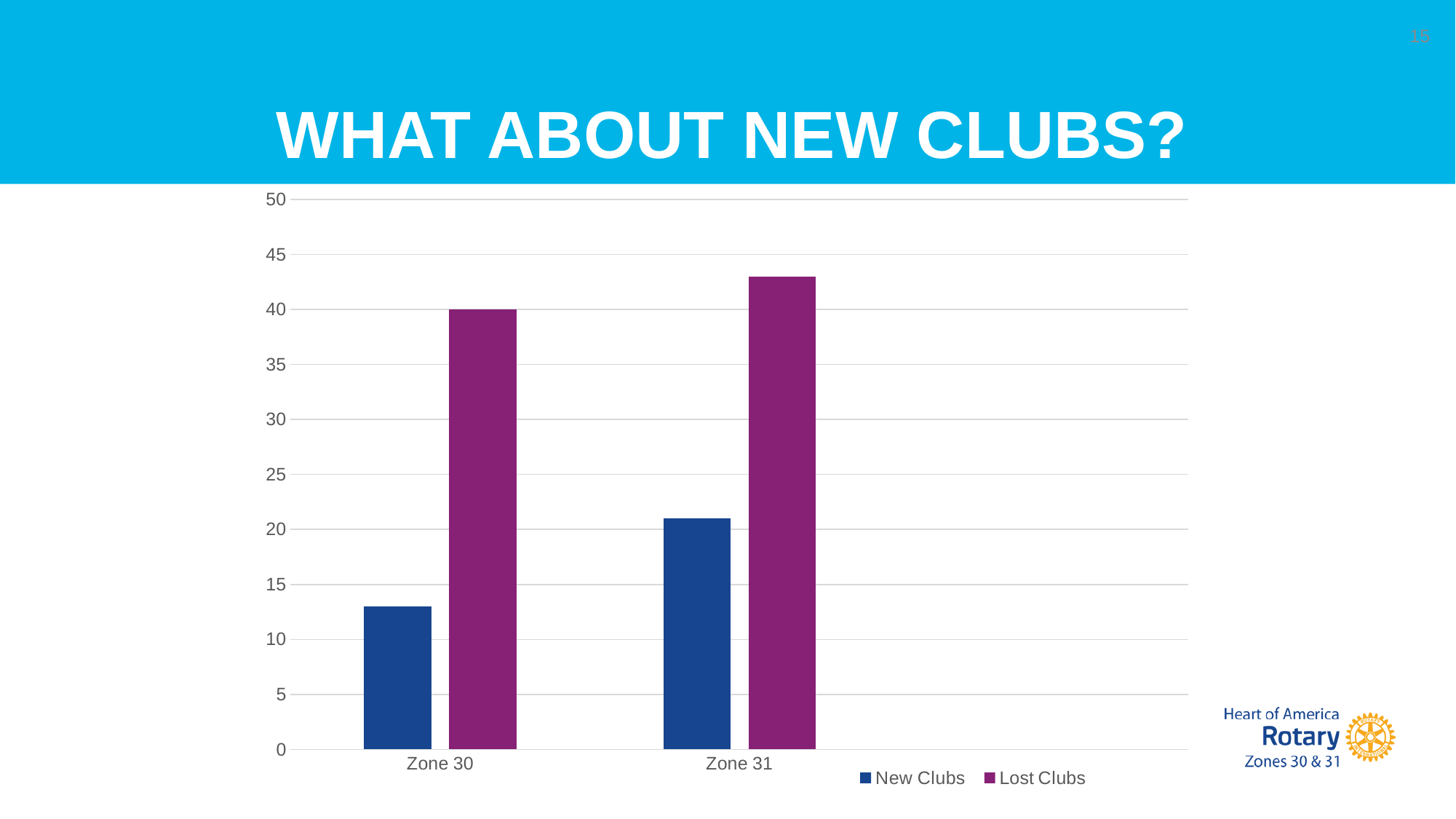
Which zone has the higher value for Lost Clubs? Zone 31 What is the value for Lost Clubs in Zone 30? 40 How many series does the legend list? 2 What kind of chart is shown on the slide? bar chart Is the value for New Clubs in Zone 31 greater or less than 20? greater In Zone 30, which is larger: New Clubs or Lost Clubs? Lost Clubs What is the title of the slide containing the chart? WHAT ABOUT NEW CLUBS? Is the value for New Clubs in Zone 30 greater or less than 15? less How many categories are shown on the x axis? 2 Which zone has the lower value for New Clubs? Zone 30 Is the value for Lost Clubs in Zone 31 greater or less than 40? greater Which series is shown in purple? Lost Clubs